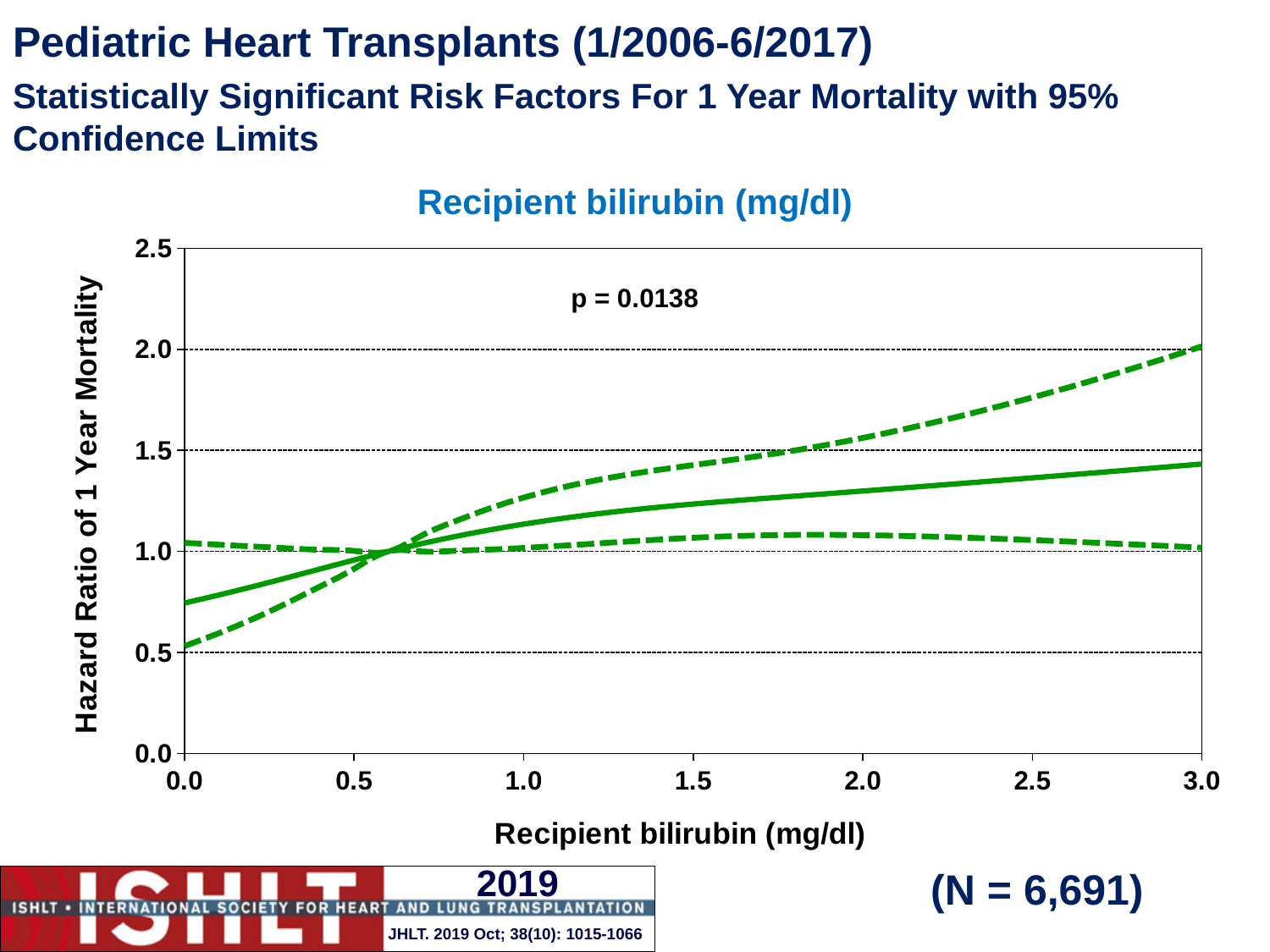
How many lines are plotted on the chart? 3 Is the hazard ratio (solid line) at a recipient bilirubin of 1.5 mg/dl greater or less than 1.0? greater Does the solid hazard ratio line rise or fall as recipient bilirubin increases from 0.0 to 3.0 mg/dl? rise What kind of chart is shown on the slide? line chart Is the upper 95% confidence limit (upper dashed line) at a recipient bilirubin of 2.5 mg/dl greater or less than 1.5? greater Is the hazard ratio (solid line) at a recipient bilirubin of 3.0 mg/dl greater or less than 1.0? greater What p-value is printed on the chart? p = 0.0138 What is the highest value shown on the y axis (Hazard Ratio of 1 Year Mortality)? 2.5 What is the title of the chart? Recipient bilirubin (mg/dl)